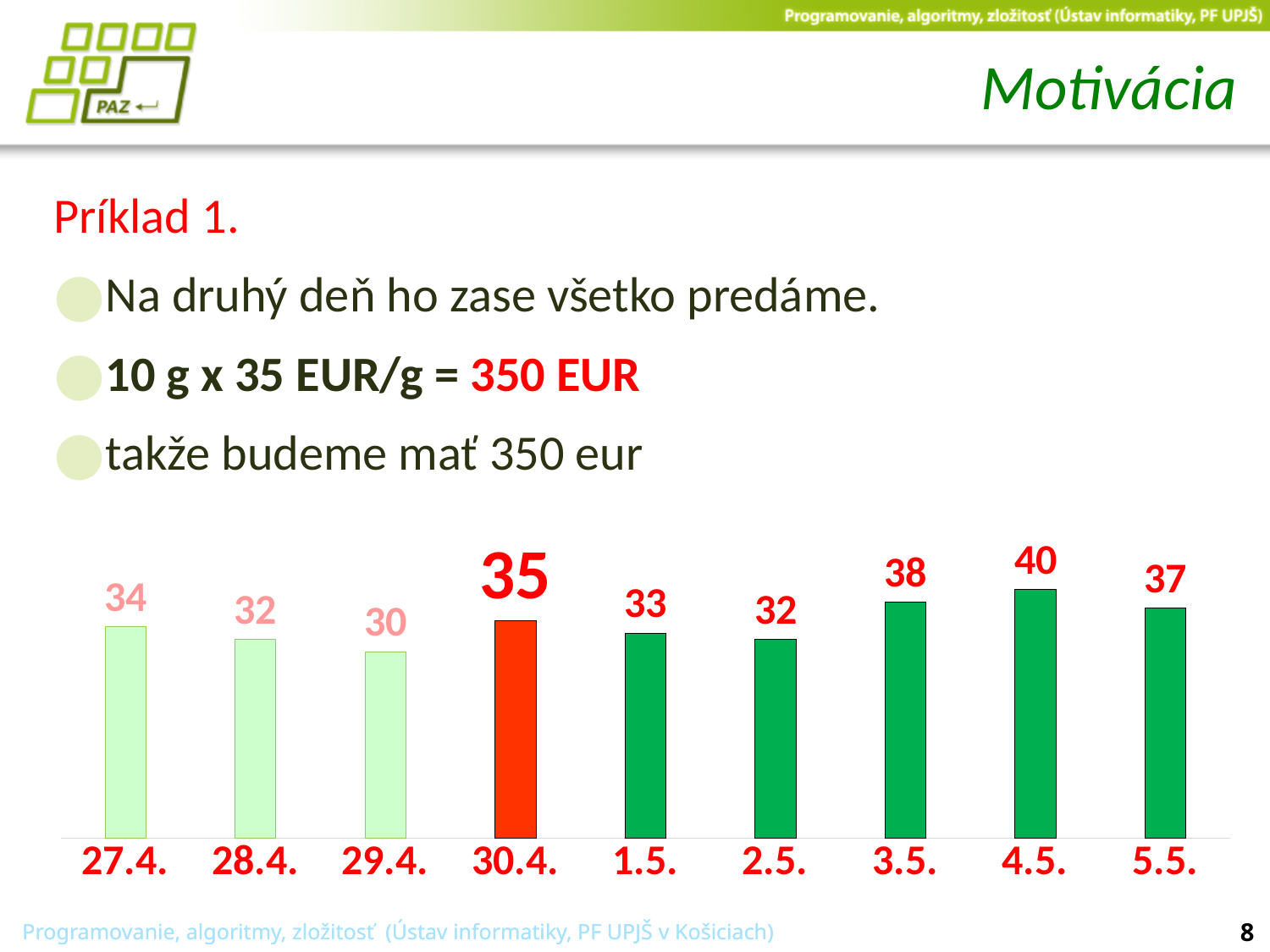
What is the value for 29.4.? 30 Which is larger, the value for 3.5. or the value for 5.5.? 3.5. Which bar is coloured red? 30.4. Which date has the highest value? 4.5. What is the difference between the values for 4.5. and 30.4.? 5 What kind of chart is shown on the slide? bar chart Do the values rise or fall from 27.4. to 29.4.? fall Which date has the lowest value? 29.4. What is the difference between the values for 27.4. and 28.4.? 2 What is the value for 4.5.? 40 What is the value for 30.4.? 35 How many dates are shown on the x axis? 9